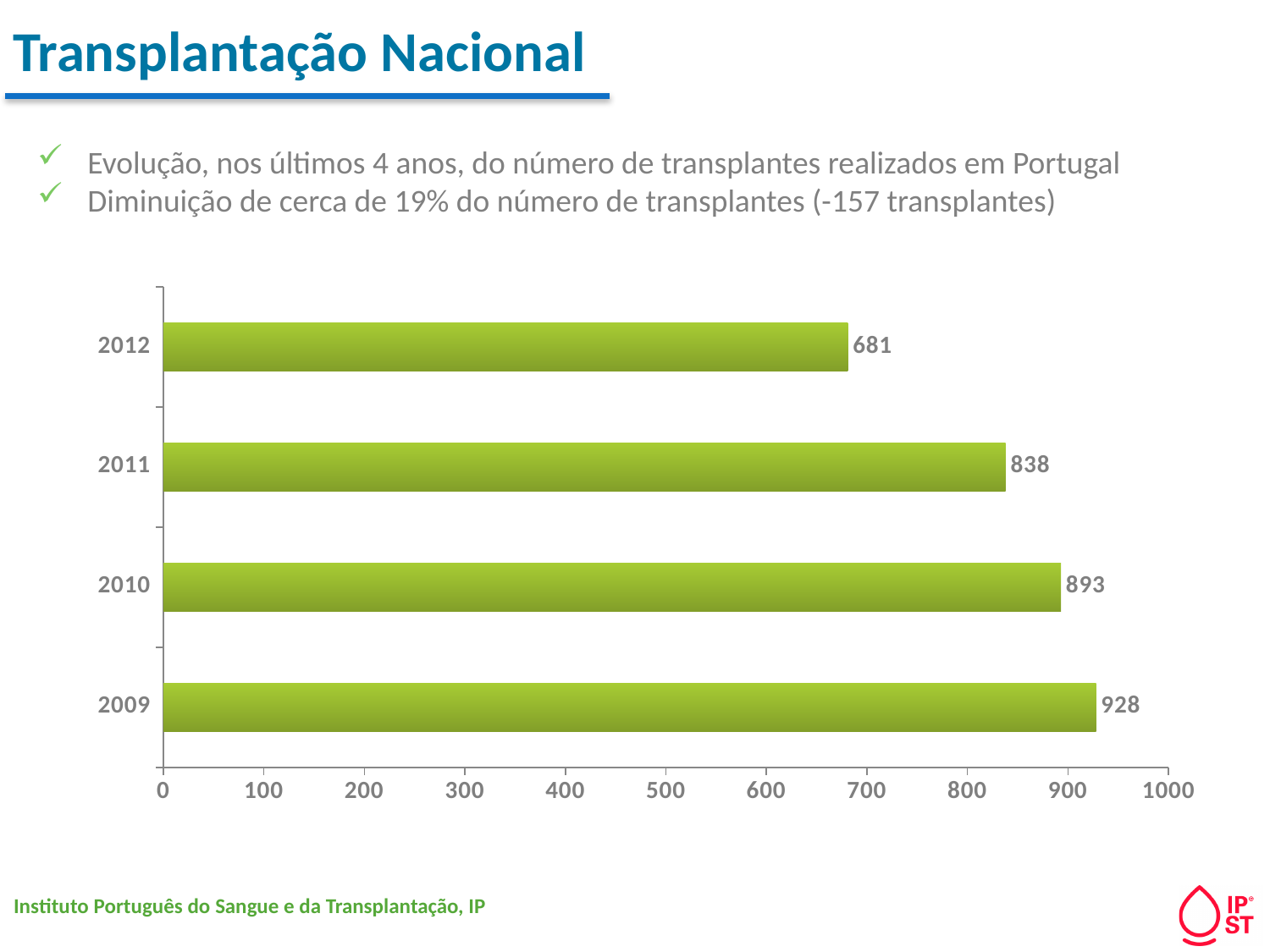
What kind of chart is shown on the slide? bar chart What is the difference between the values for 2009 and 2012? 247 Which is larger, the value for 2010 or the value for 2011? 2010 What is the value for 2012? 681 Is the value for 2012 greater or less than 700? less What is the difference between the values for 2011 and 2012? 157 What is the value for 2009? 928 What is the value for 2011? 838 Which year has the lowest value? 2012 How many years are shown in the chart? 4 What is the value for 2010? 893 Which year has the highest value? 2009